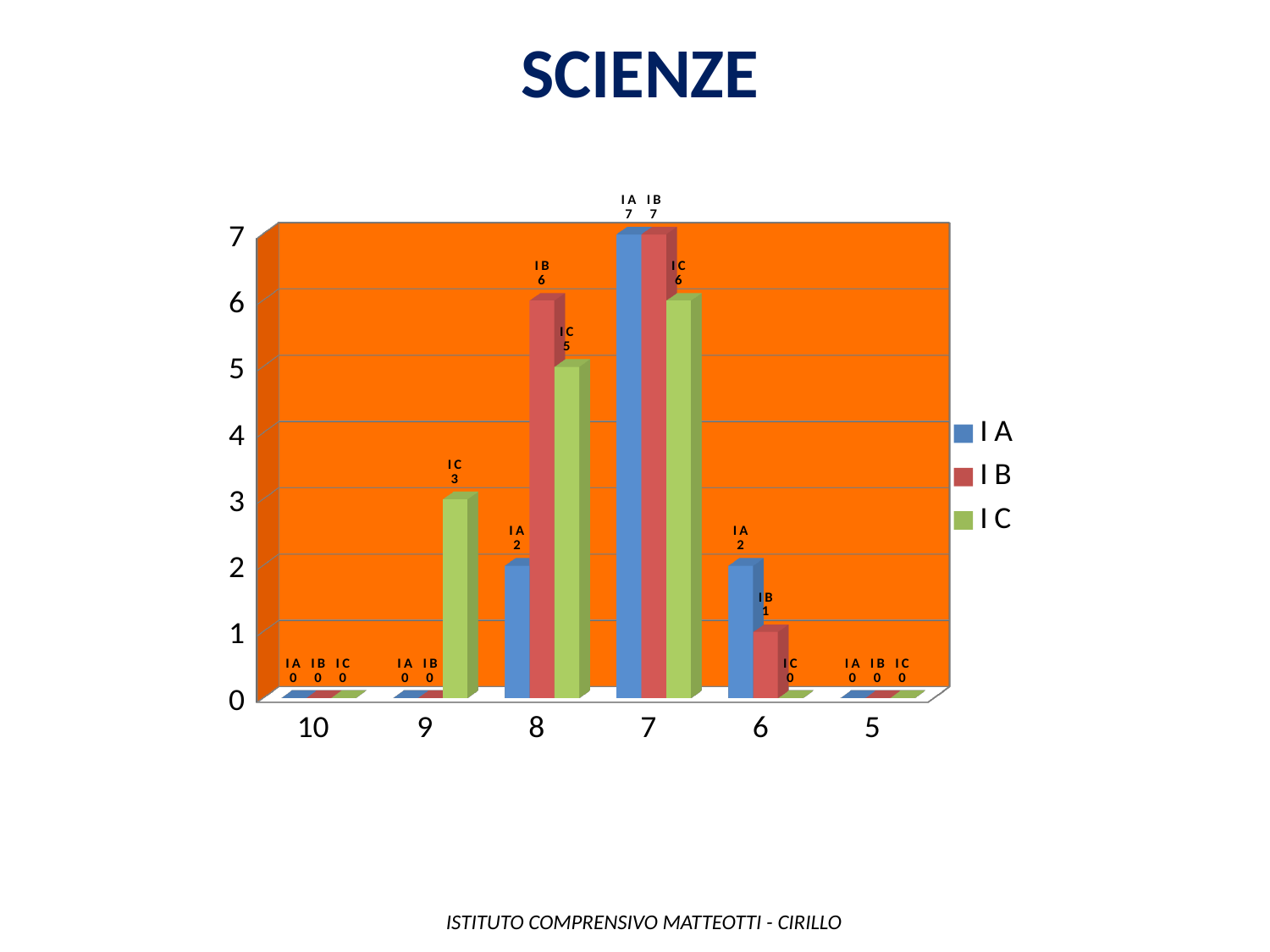
At which grade does I A reach its highest value? 7 How many series does the legend list? 3 What is the value for I A at grade 6? 2 What is the title of the chart? SCIENZE What kind of chart is shown? bar chart Which is larger at grade 6, I A or I B? I A How many grade categories are shown on the x axis? 6 What is the value for I C at grade 7? 6 What is the value for I C at grade 9? 3 What is the difference between I B and I A at grade 8? 4 What is the value for I B at grade 8? 6 What is the total of I A, I B and I C at grade 7? 20